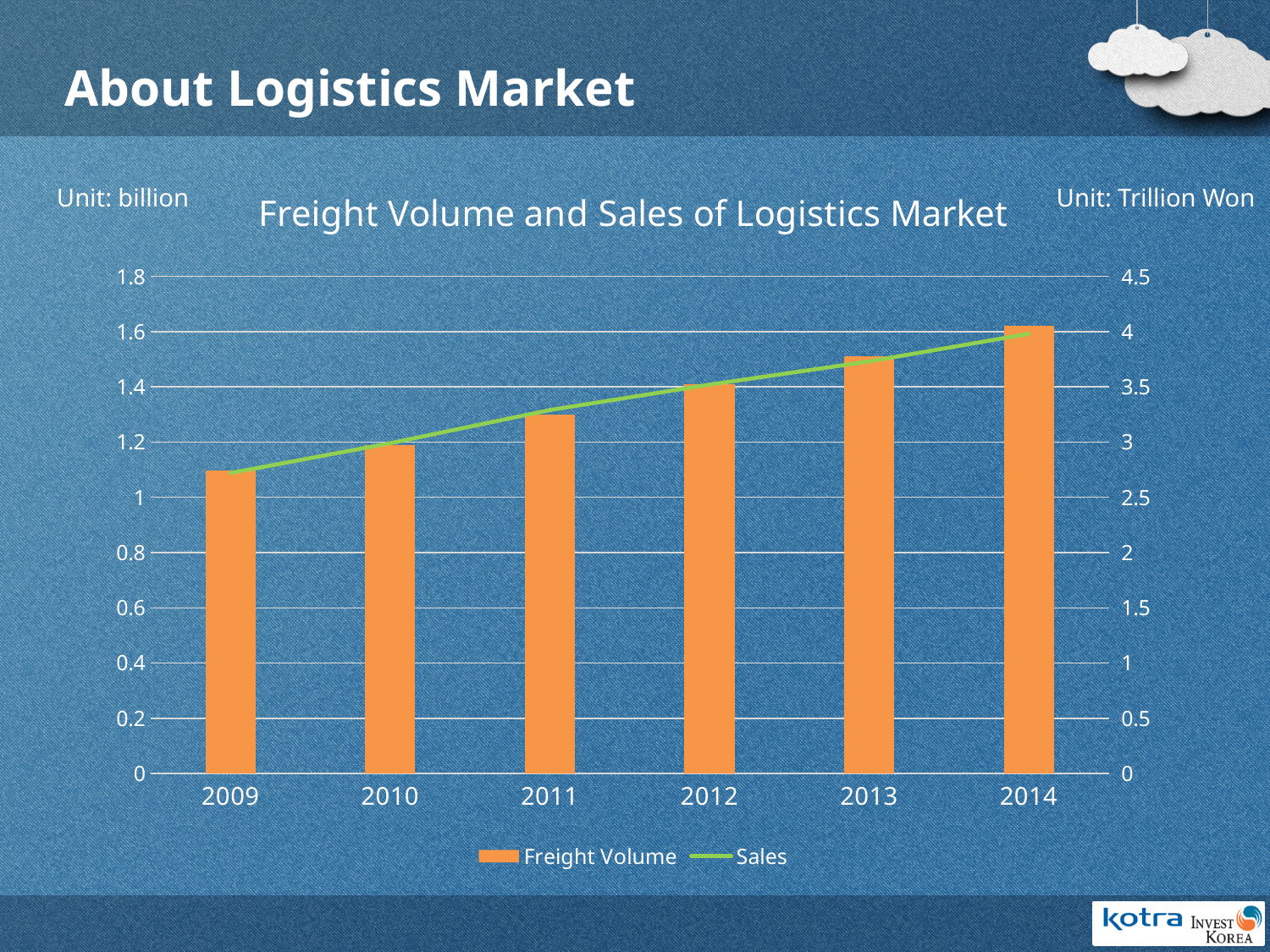
How many years are shown on the x axis? 6 Which year has the highest Freight Volume? 2014 Is the Freight Volume for 2009 greater or less than 1.2? less Which year has the lowest Freight Volume? 2009 Is the Freight Volume for 2013 greater or less than 1.6? less How many series does the legend list? 2 What unit is shown for the right-hand axis? Trillion Won What is the title of the chart? Freight Volume and Sales of Logistics Market Do the Freight Volume bars rise or fall from 2009 to 2014? rise What kind of chart is used to show Freight Volume? bar chart Is the Freight Volume for 2014 greater or less than 1.4? greater Which year has the larger Freight Volume, 2010 or 2012? 2012